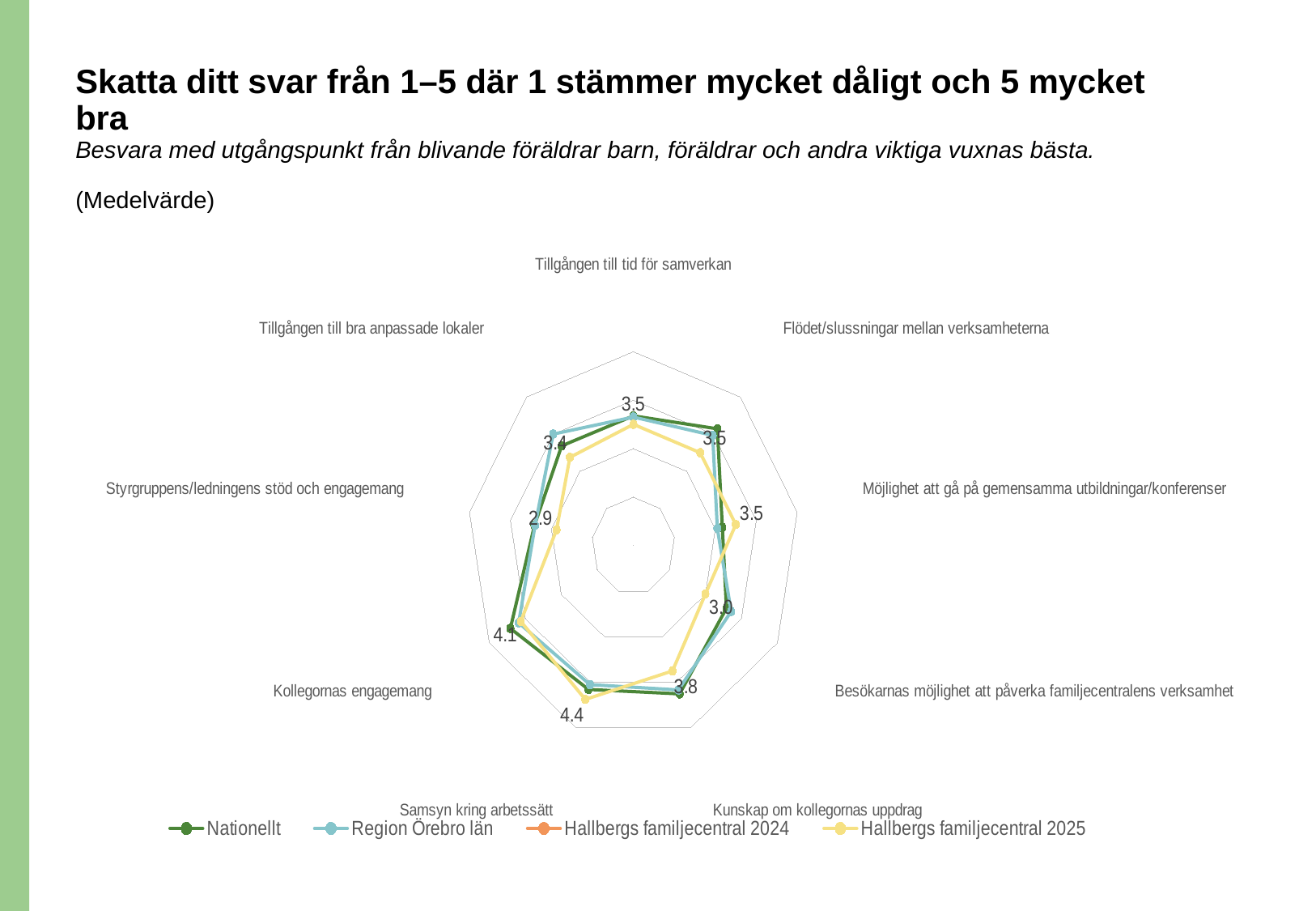
What data label is printed on the 'Samsyn kring arbetssätt' axis of the radar chart? 4.4 What data label is printed on the 'Kollegornas engagemang' axis of the radar chart? 4.1 What data label is printed on the 'Styrgruppens/ledningens stöd och engagemang' axis of the radar chart? 2.9 Which axis of the radar chart carries the lowest printed data label? Styrgruppens/ledningens stöd och engagemang How many categories (axes) does the radar chart have? 9 What is the difference between the printed data labels on the 'Samsyn kring arbetssätt' axis and the 'Styrgruppens/ledningens stöd och engagemang' axis? 1.5 Which series is shown in green in the radar chart's legend? Nationellt Which printed data label is larger: the one on the 'Kollegornas engagemang' axis or the one on the 'Kunskap om kollegornas uppdrag' axis? Kollegornas engagemang What kind of chart is shown on the slide? Radar chart Which axis of the radar chart carries the highest printed data label? Samsyn kring arbetssätt How many series does the legend of the radar chart list? 4 What data label is printed on the 'Besökarnas möjlighet att påverka familjecentralens verksamhet' axis of the radar chart? 3.0